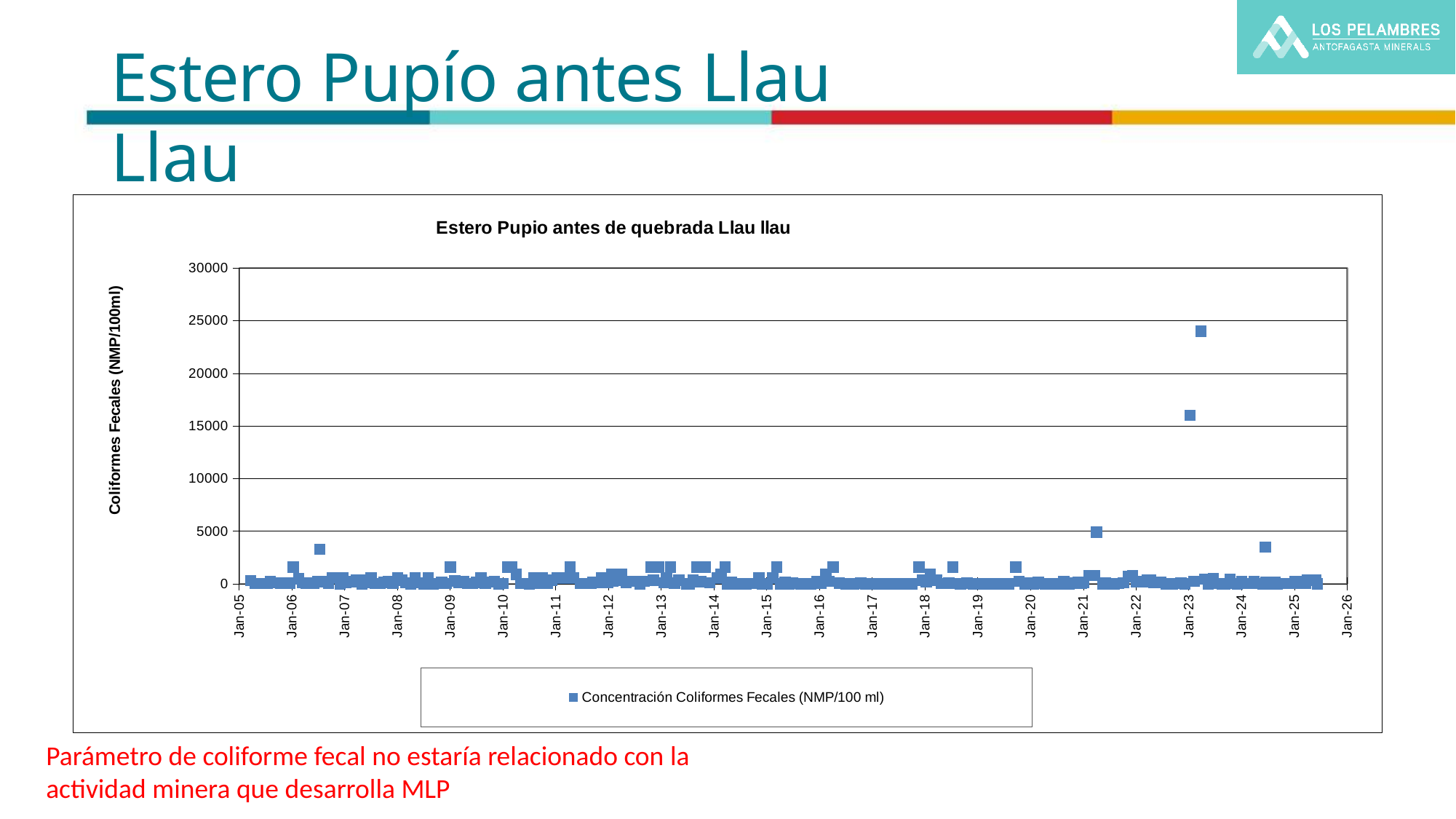
What is the legend entry for the plotted series? Concentración Coliformes Fecales (NMP/100 ml) What is the title of the chart? Estero Pupio antes de quebrada Llau llau What kind of chart is shown on the slide? scatter chart Is the highest plotted value greater or less than 20000? greater What is the maximum value shown on the y axis? 30000 Is the isolated high point between Jan-24 and Jan-25 greater or less than 5000? less Around which x-axis label does the highest plotted value occur? Jan-23 Is the isolated high point between Jan-06 and Jan-07 greater or less than 5000? less How many series does the legend list? 1 How many labelled ticks are there on the x axis, from Jan-05 to Jan-26? 22